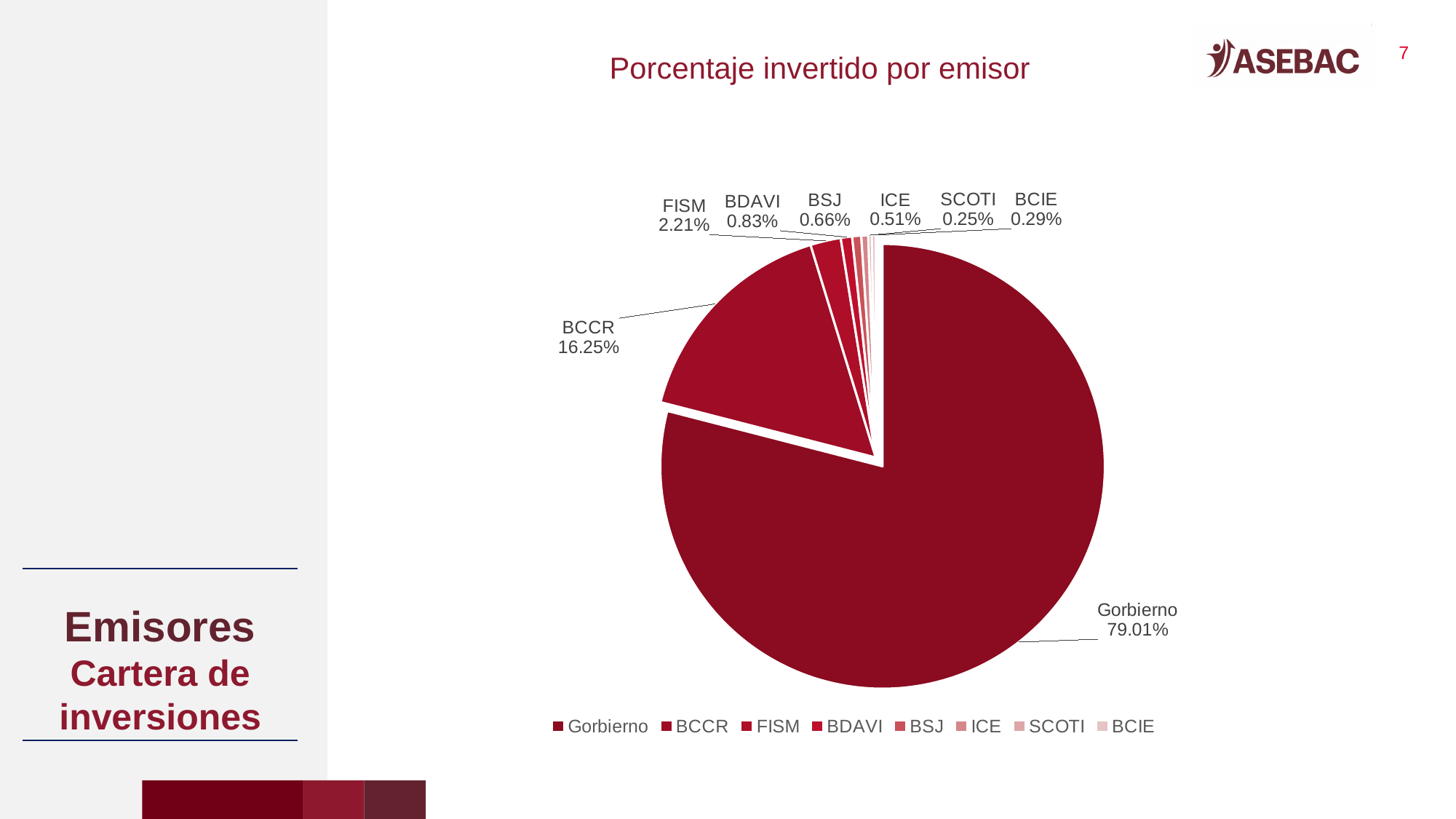
Which emisor has the largest share of the pie? Gorbierno What is the difference between the Gorbierno and BCCR percentages? 62.76% What is the title of the chart? Porcentaje invertido por emisor Which emisor has the smallest share of the pie? SCOTI What percentage is shown for FISM? 2.21% What percentage is shown for Gorbierno? 79.01% What type of chart is shown on the slide? pie chart What percentage is shown for ICE? 0.51% How many slices does the pie chart have? 8 How many entries does the legend list? 8 Which is larger, the share for BDAVI or the share for BSJ? BDAVI What percentage is shown for BCCR? 16.25%